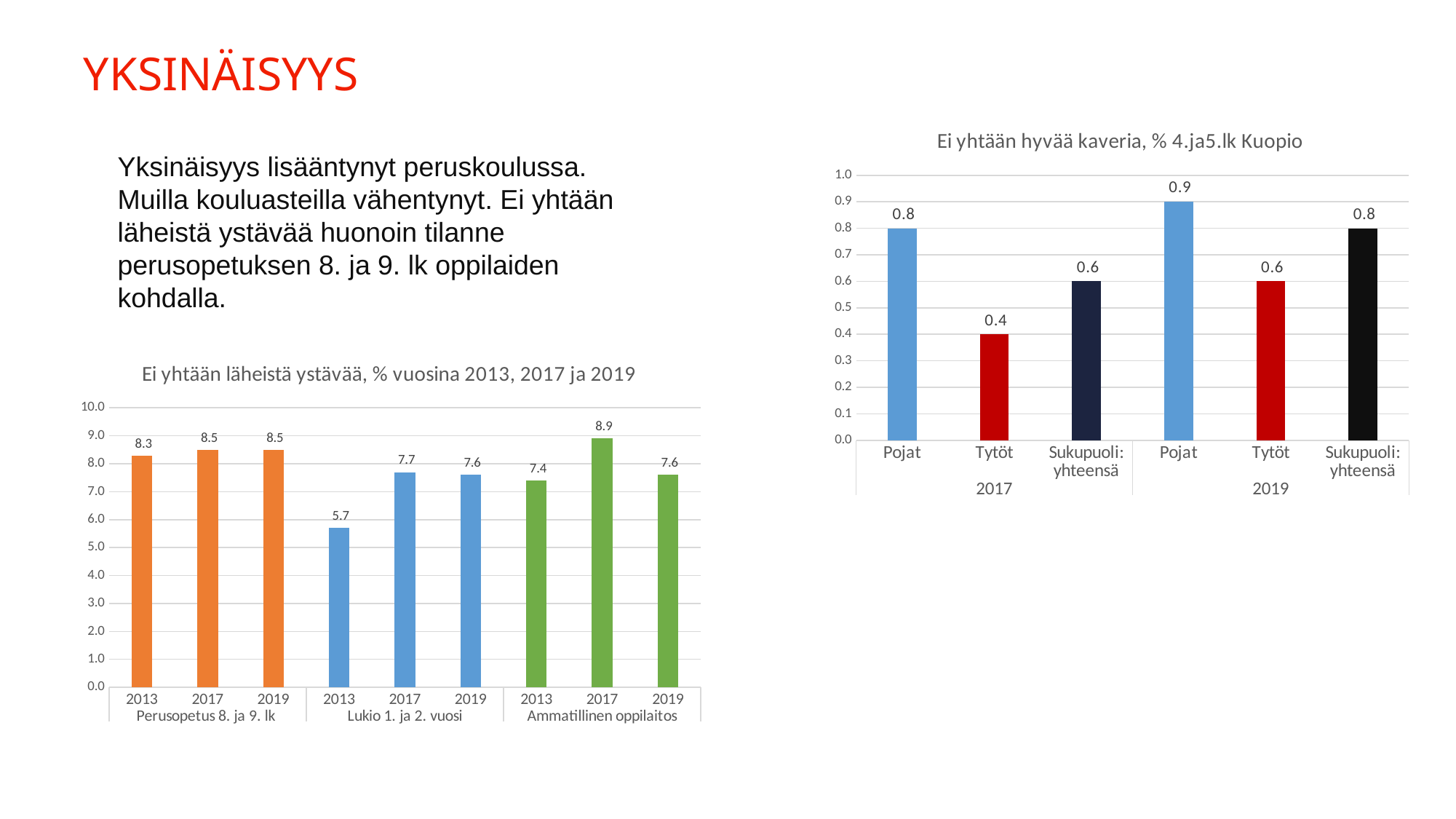
In the chart titled 'Ei yhtään läheistä ystävää, % vuosina 2013, 2017 ja 2019', what is the value for Ammatillinen oppilaitos in 2017? 8.9 In the chart titled 'Ei yhtään läheistä ystävää, % vuosina 2013, 2017 ja 2019', how many bars are plotted? 9 In the chart titled 'Ei yhtään läheistä ystävää, % vuosina 2013, 2017 ja 2019', what is the difference between the 2017 and 2013 values for Lukio 1. ja 2. vuosi? 2.0 In the chart titled 'Ei yhtään läheistä ystävää, % vuosina 2013, 2017 ja 2019', which bar has the lowest value? Lukio 1. ja 2. vuosi 2013 In the chart titled 'Ei yhtään läheistä ystävää, % vuosina 2013, 2017 ja 2019', what is the value for Lukio 1. ja 2. vuosi in 2013? 5.7 In the chart titled 'Ei yhtään hyvää kaveria, % 4.ja5.lk Kuopio', what is the value for Tytöt in 2017? 0.4 In the chart titled 'Ei yhtään läheistä ystävää, % vuosina 2013, 2017 ja 2019', do the values for Perusopetus 8. ja 9. lk rise or fall from 2013 to 2019? rise What kind of chart is the one titled 'Ei yhtään hyvää kaveria, % 4.ja5.lk Kuopio'? bar chart In the chart titled 'Ei yhtään hyvää kaveria, % 4.ja5.lk Kuopio', what is the difference between Sukupuoli: yhteensä in 2019 and in 2017? 0.2 In the chart titled 'Ei yhtään läheistä ystävää, % vuosina 2013, 2017 ja 2019', which bar has the highest value? Ammatillinen oppilaitos 2017 In the chart titled 'Ei yhtään hyvää kaveria, % 4.ja5.lk Kuopio', which is larger: Tytöt in 2017 or Tytöt in 2019? Tytöt in 2019 In the chart titled 'Ei yhtään hyvää kaveria, % 4.ja5.lk Kuopio', which bar has the highest value? Pojat 2019